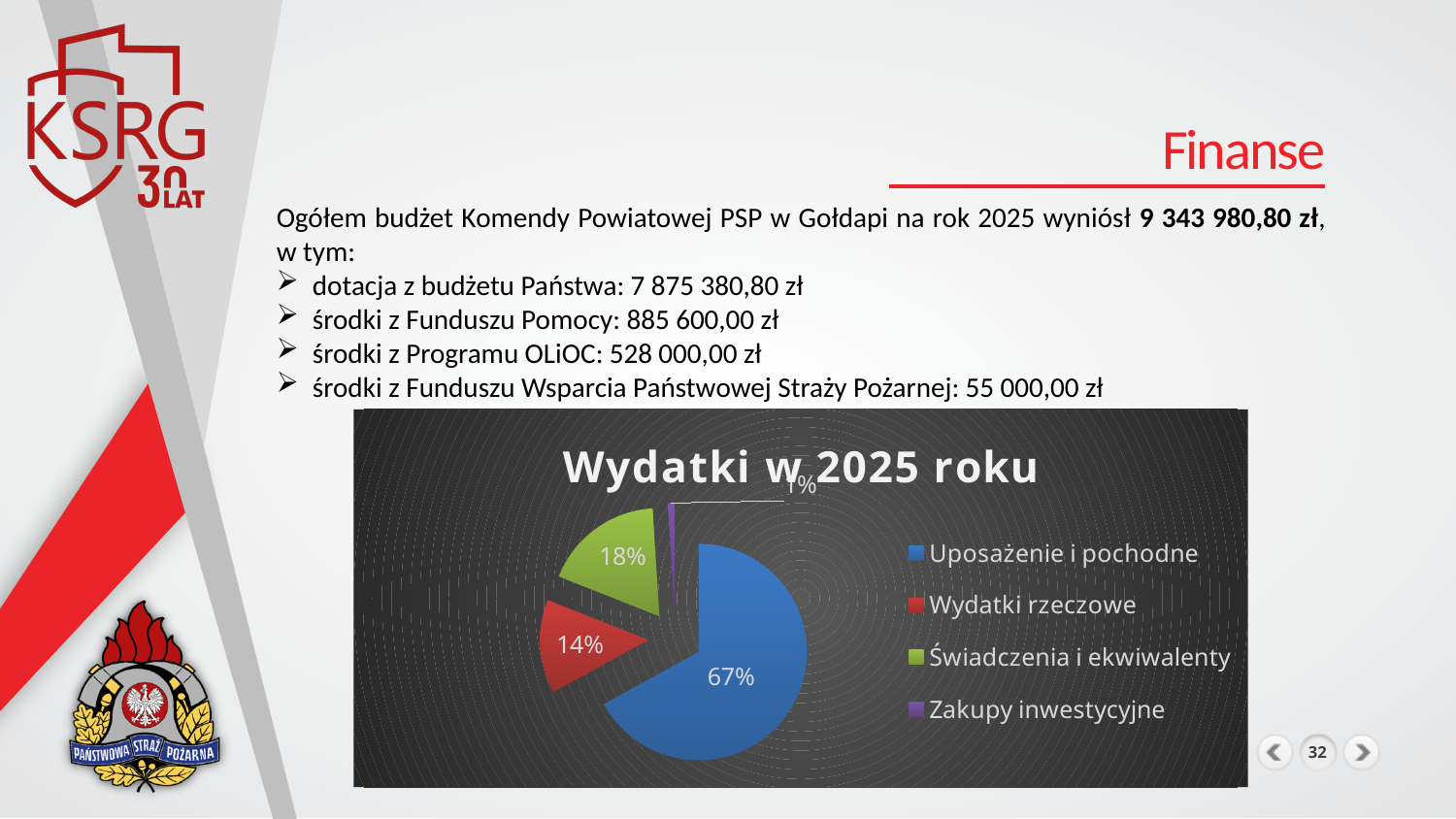
What share of the pie is Świadczenia i ekwiwalenty? 18% What is the title of the chart? Wydatki w 2025 roku How many categories does the chart's legend list? 4 What share of the pie is Uposażenie i pochodne? 67% Which is larger, the share for Świadczenia i ekwiwalenty or the share for Wydatki rzeczowe? Świadczenia i ekwiwalenty What type of chart is shown on the slide? pie chart Which category has the smallest slice of the pie? Zakupy inwestycyjne What share of the pie is Wydatki rzeczowe? 14% Which category has the largest slice of the pie? Uposażenie i pochodne What is the difference in percentage points between Świadczenia i ekwiwalenty and Wydatki rzeczowe? 4 Which colour represents Wydatki rzeczowe in the chart? red What is the difference in percentage points between Uposażenie i pochodne and Świadczenia i ekwiwalenty? 49